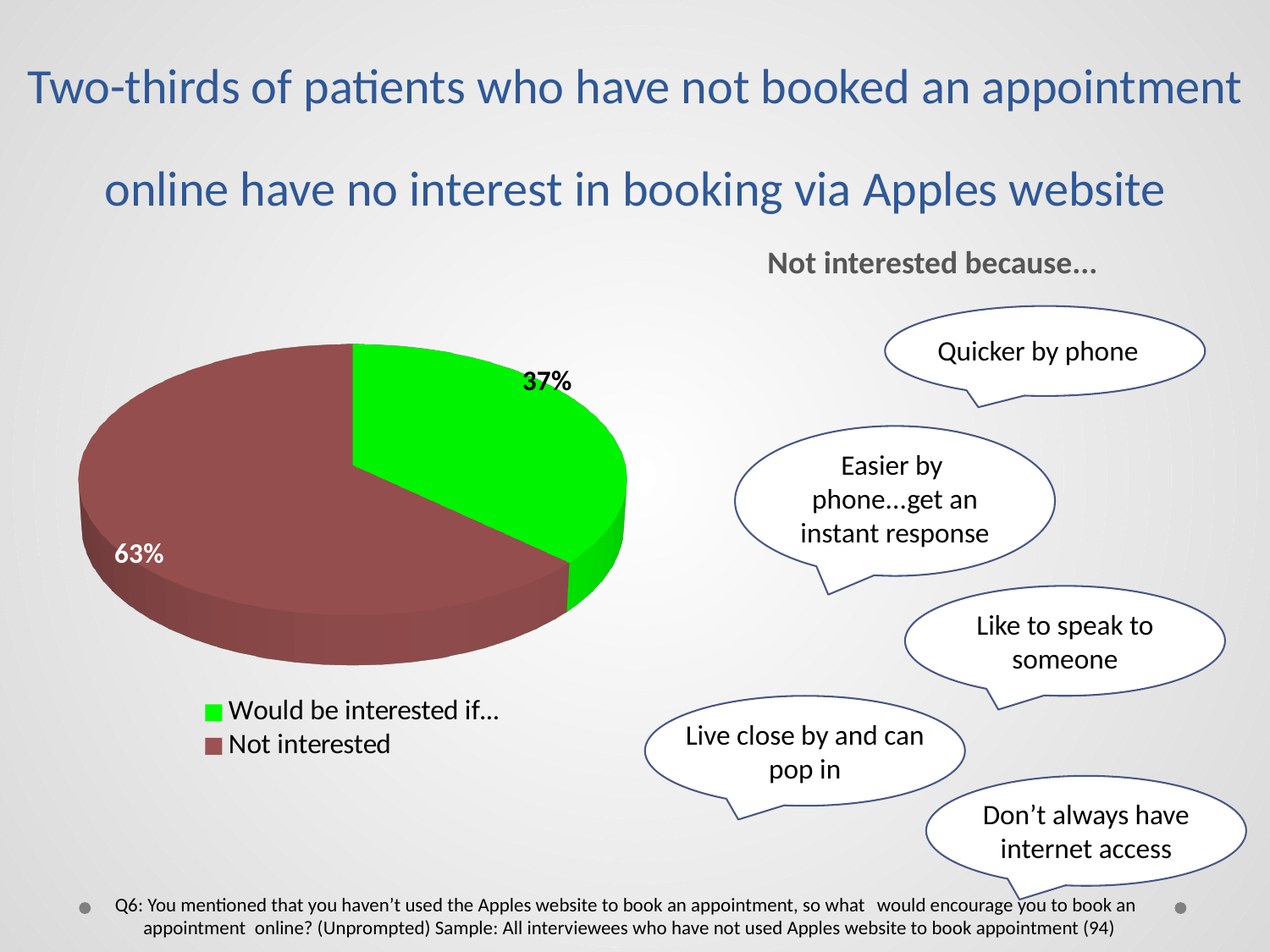
What colour is the 'Not interested' slice? Brown Which is larger: the share for 'Not interested' or for 'Would be interested if...'? Not interested What percentage of patients are 'Not interested'? 63% How many slices does the pie chart have? 2 What is the difference in percentage points between 'Not interested' and 'Would be interested if...'? 26 What percentage of patients 'Would be interested if...'? 37% What kind of chart is shown on the slide? Pie chart Which slice of the pie is the smallest? Would be interested if... What colour is the 'Would be interested if...' slice? Green Is the share for 'Not interested' greater or less than 50%? greater Which slice of the pie is the largest? Not interested How many entries does the legend list? 2